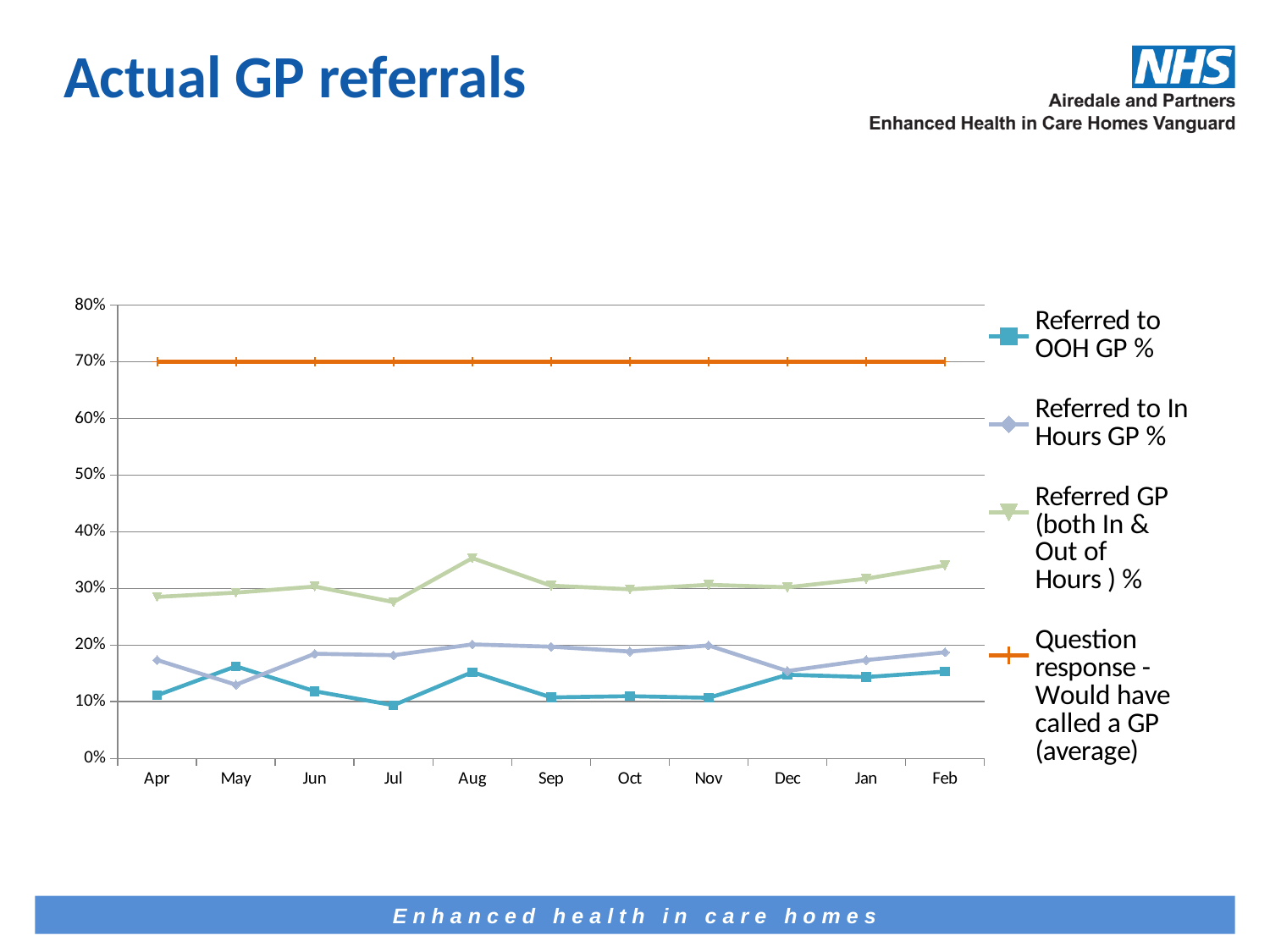
In which month is 'Referred GP (both In & Out of Hours) %' lowest? Jul Does the 'Question response - Would have called a GP (average)' line rise, fall or stay flat from Apr to Feb? stays flat What is the value of the 'Question response - Would have called a GP (average)' line? 70% How many months are shown on the x axis? 11 Is the value for 'Referred GP (both In & Out of Hours) %' in Aug greater or less than 30%? greater What kind of chart is shown on the slide? line chart In Apr, which is higher: 'Referred to OOH GP %' or 'Referred to In Hours GP %'? Referred to In Hours GP % Which series is drawn as the orange line? Question response - Would have called a GP (average) In which month is 'Referred GP (both In & Out of Hours) %' highest? Aug In which month is 'Referred to In Hours GP %' lowest? May Is the value for 'Referred to In Hours GP %' in May greater or less than 20%? less How many series does the legend list? 4